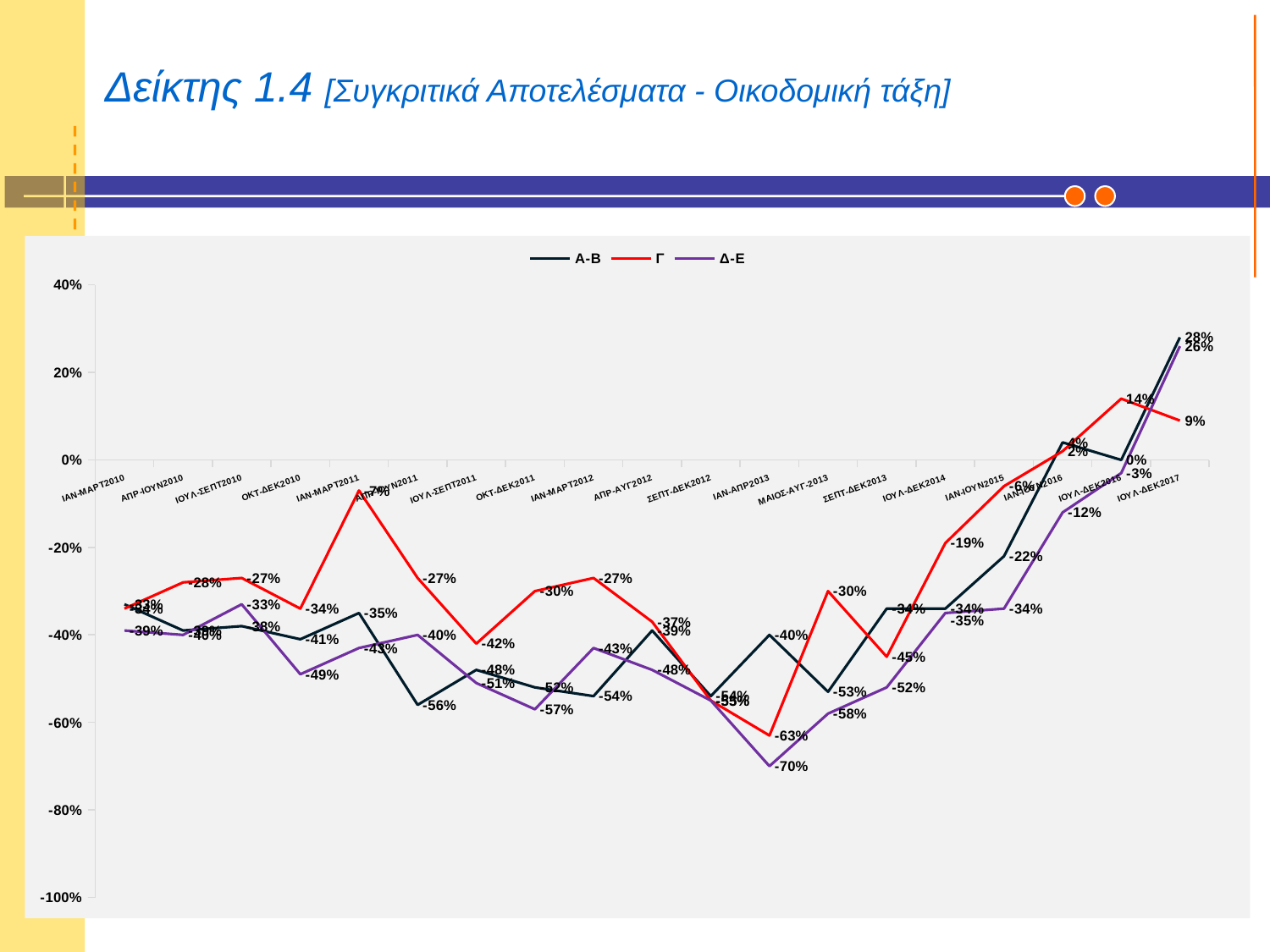
How many time periods are plotted along the x axis? 19 In which period does the Δ-Ε series reach its lowest value? ΙΑΝ-ΑΠΡ2013 In which period does the Α-Β series reach its highest value? ΙΟΥΛ-ΔΕΚ2017 How many series does the legend list? 3 What is the difference between the Γ value (-63%) and the Δ-Ε value (-70%) for ΙΑΝ-ΑΠΡ2013? 7 percentage points Does the Δ-Ε series rise or fall from ΙΑΝ-ΑΠΡ2013 to ΙΟΥΛ-ΔΕΚ2017? Rise What is the value of the Γ series for ΑΠΡ-ΙΟΥΝ2011? -27% What is the value of the Γ series for ΙΟΥΛ-ΔΕΚ2016? 14% For ΙΟΥΛ-ΣΕΠΤ2011, which series has the higher value, Γ or Α-Β? Γ What is the value of the Α-Β series for ΙΟΥΛ-ΔΕΚ2017? 28% What kind of chart is shown on the slide? Line chart What is the value of the Δ-Ε series for ΙΑΝ-ΑΠΡ2013? -70%